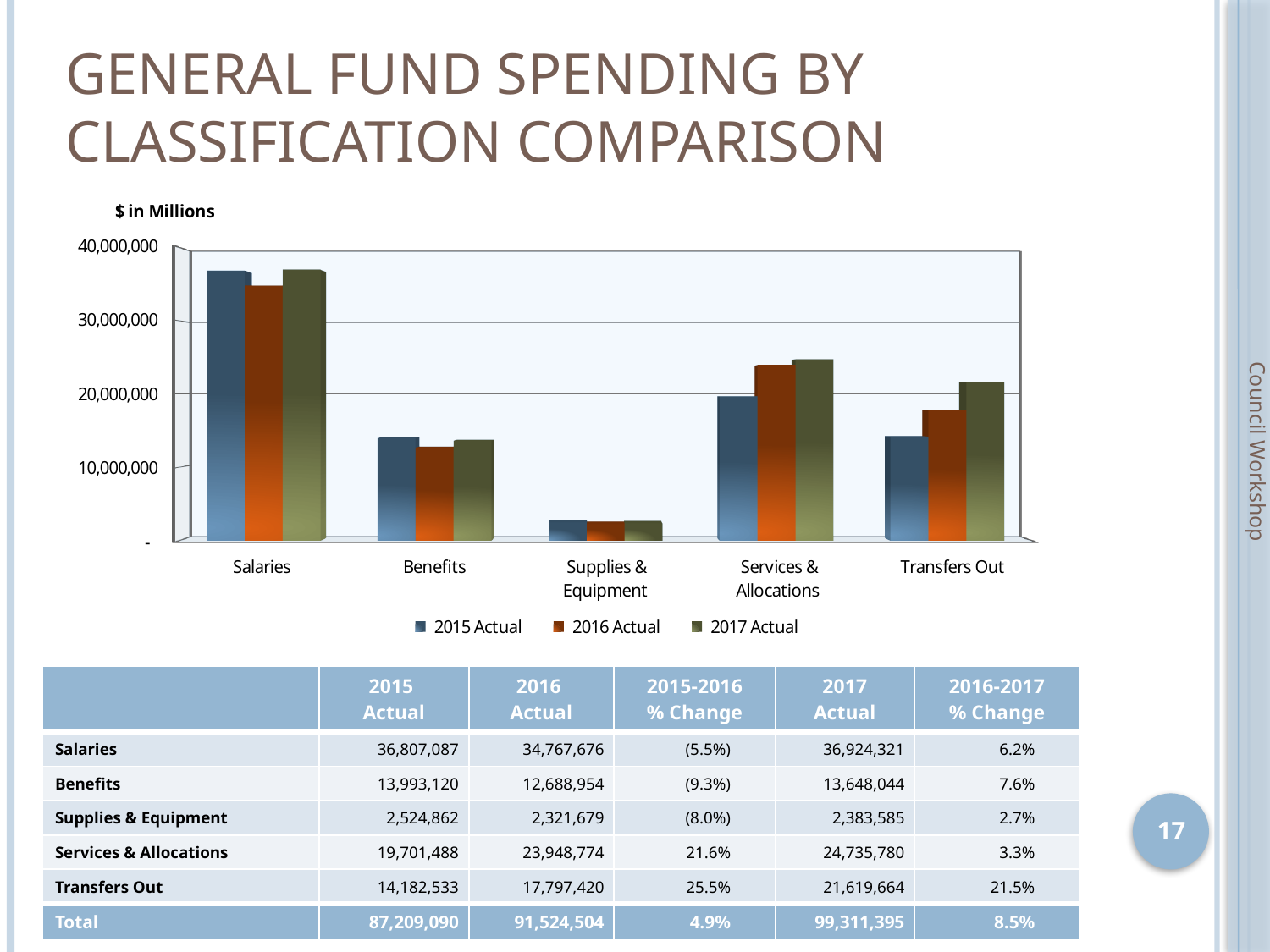
What is the 2017 Actual value for Services & Allocations shown in the table? 24,735,780 Is the 2016 Actual value for Services & Allocations greater or less than 20,000,000? greater What kind of chart is shown on the slide? bar chart Is the 2015 Actual value for Transfers Out greater or less than 20,000,000? less What unit label is shown above the chart's vertical axis? $ in Millions Which classification has the lowest spending in 2015 Actual? Supplies & Equipment What is the 2016-2017 % Change for Transfers Out shown in the table? 21.5% How many spending classifications are shown on the x axis of the chart? 5 Do the Transfers Out values rise or fall from 2015 Actual to 2017 Actual? rise Which is larger for Benefits: the 2015 Actual value or the 2016 Actual value? 2015 Actual Which classification has the highest spending in 2017 Actual? Salaries How many series does the chart legend list? 3